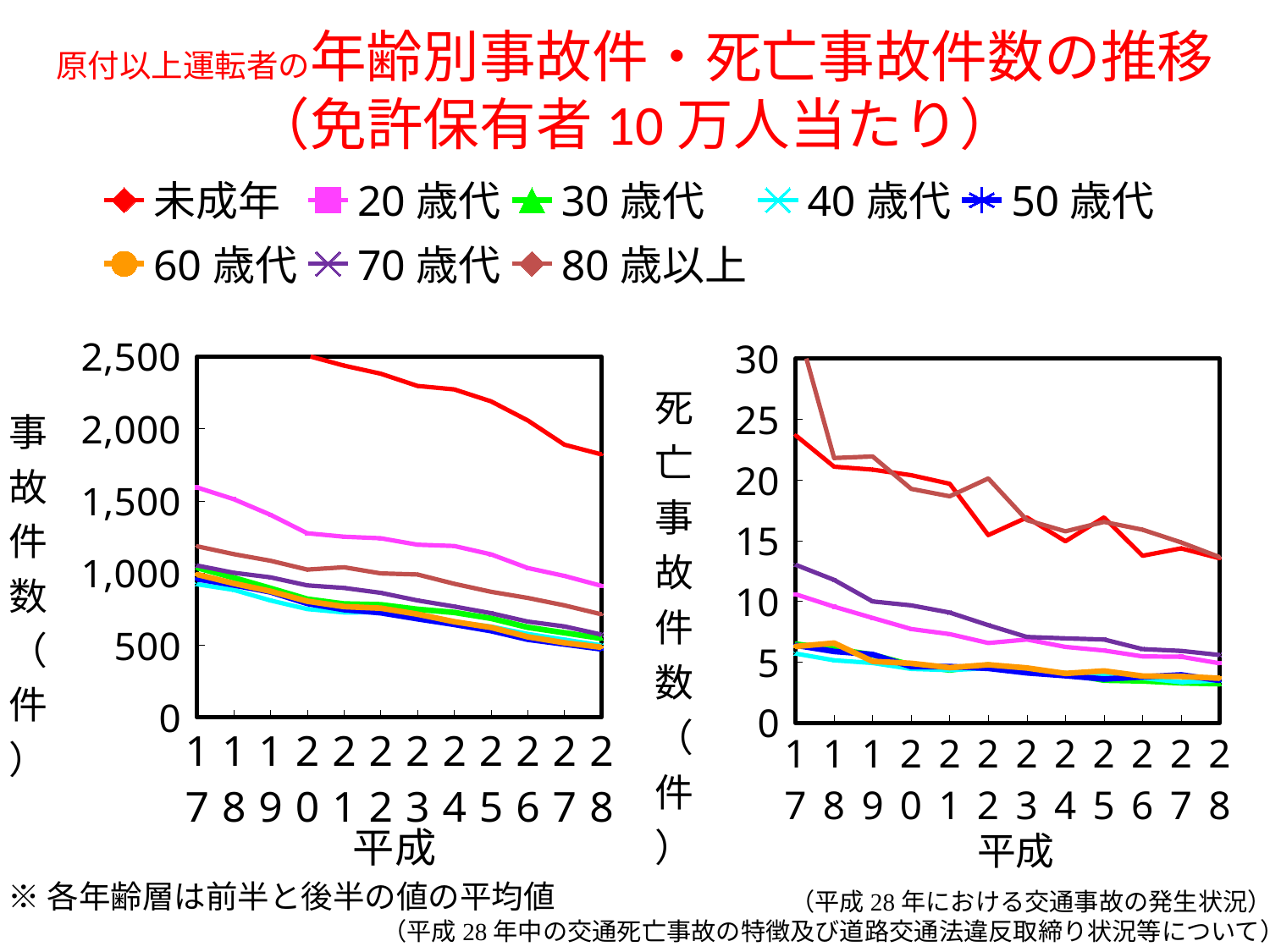
In the right chart (死亡事故件数), do the values for 80歳以上 rise or fall from 平成17 to 平成28? fall How many series does the legend list? 8 In the right chart (死亡事故件数), which is larger in 平成17, 70歳代 or 20歳代? 70歳代 In the left chart (事故件数), how many years are plotted along the x axis? 12 In the left chart (事故件数), which age group has the highest values across all years? 未成年 In the left chart (事故件数), is the value for 未成年 in 平成28 greater or less than 1,500? greater What kind of chart is the left chart (事故件数)? line chart In the right chart (死亡事故件数), is the value for 未成年 in 平成17 greater or less than 25? less In the right chart (死亡事故件数), which age group has the highest value in 平成17? 80歳以上 In the left chart (事故件数), which is larger in 平成17, 20歳代 or 80歳以上? 20歳代 In the left chart (事故件数), do the values for 未成年 rise or fall from 平成20 to 平成28? fall In the left chart (事故件数), is the value for 20歳代 in 平成17 greater or less than 1,500? greater